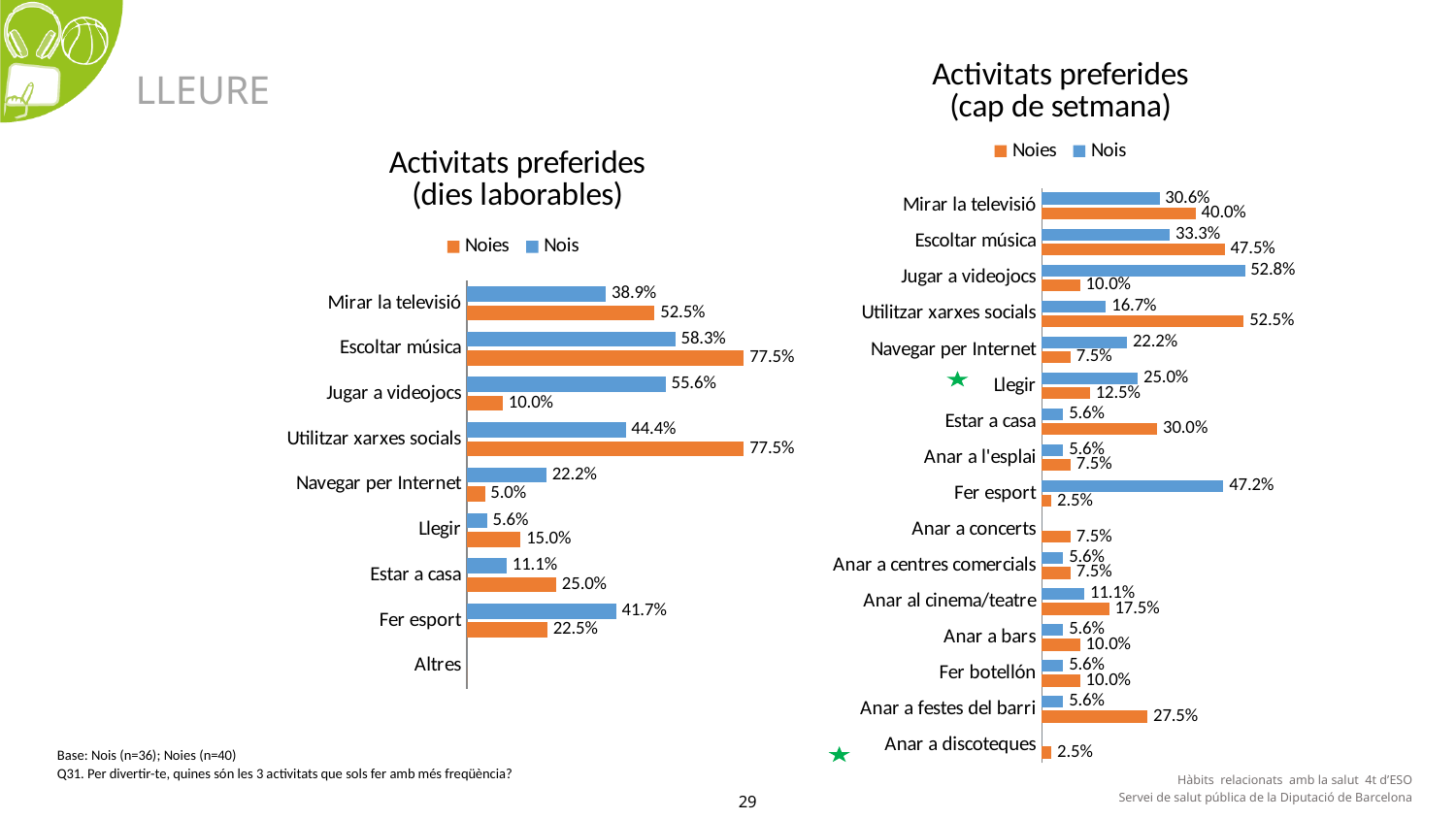
In the 'Activitats preferides (cap de setmana)' chart, which activity has the highest value for Noies? Utilitzar xarxes socials In the 'Activitats preferides (dies laborables)' chart, what is the difference between Noies and Nois for Utilitzar xarxes socials? 33.1% In the 'Activitats preferides (dies laborables)' chart, what is the value for Nois for Jugar a videojocs? 55.6% In the 'Activitats preferides (cap de setmana)' chart, which activity has the lowest value for Noies? Fer esport and Anar a discoteques (both 2.5%) In the 'Activitats preferides (cap de setmana)' chart, what is the difference between Nois and Noies for Jugar a videojocs? 42.8% In the 'Activitats preferides (dies laborables)' chart, which is larger for Fer esport, Nois or Noies? Nois What kind of chart is 'Activitats preferides (cap de setmana)'? Bar chart In the 'Activitats preferides (dies laborables)' chart, which activity has the highest value for Nois? Escoltar música In the 'Activitats preferides (dies laborables)' chart, what is the value for Noies for Escoltar música? 77.5% In the 'Activitats preferides (dies laborables)' chart, how many series does the legend list? 2 In the 'Activitats preferides (cap de setmana)' chart, what is the value for Nois for Fer esport? 47.2% In the 'Activitats preferides (cap de setmana)' chart, what is the value for Noies for Anar a festes del barri? 27.5%